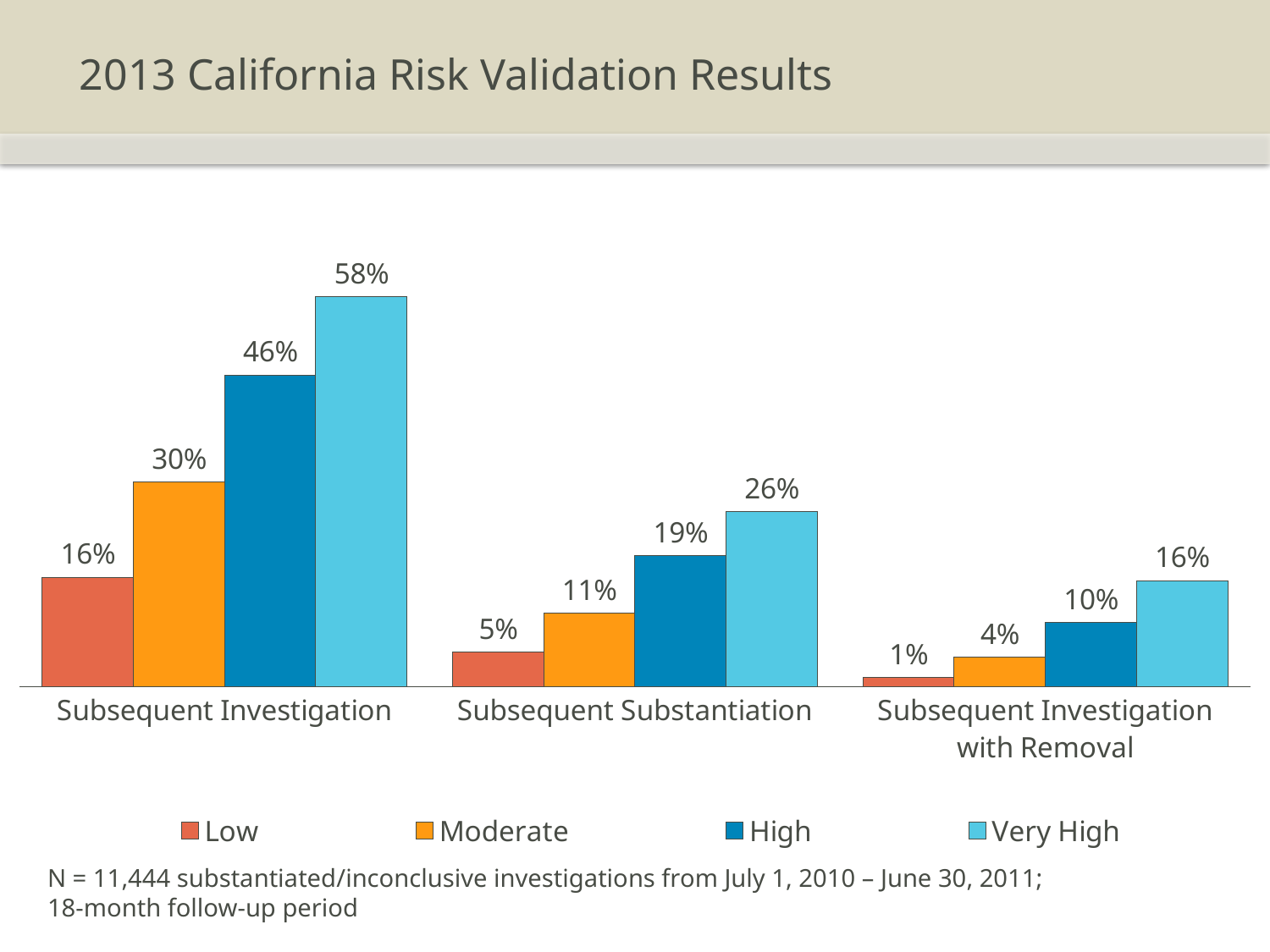
Which is larger: the Moderate value for Subsequent Investigation or the Very High value for Subsequent Substantiation? Moderate value for Subsequent Investigation What is the difference between the High and Moderate values in the Subsequent Substantiation category? 8% How many series does the legend list? 4 What kind of chart is shown on the slide? Bar chart Which risk level has the lowest value in the Subsequent Investigation with Removal category? Low Which risk level has the highest value in the Subsequent Investigation category? Very High What is the value for Moderate in the Subsequent Investigation with Removal category? 4% What is the difference between the Very High and Low values in the Subsequent Investigation category? 42% How many categories are shown on the x axis? 3 What is the value for Very High in the Subsequent Investigation category? 58% What is the value for Low in the Subsequent Substantiation category? 5% What is the value for High in the Subsequent Substantiation category? 19%